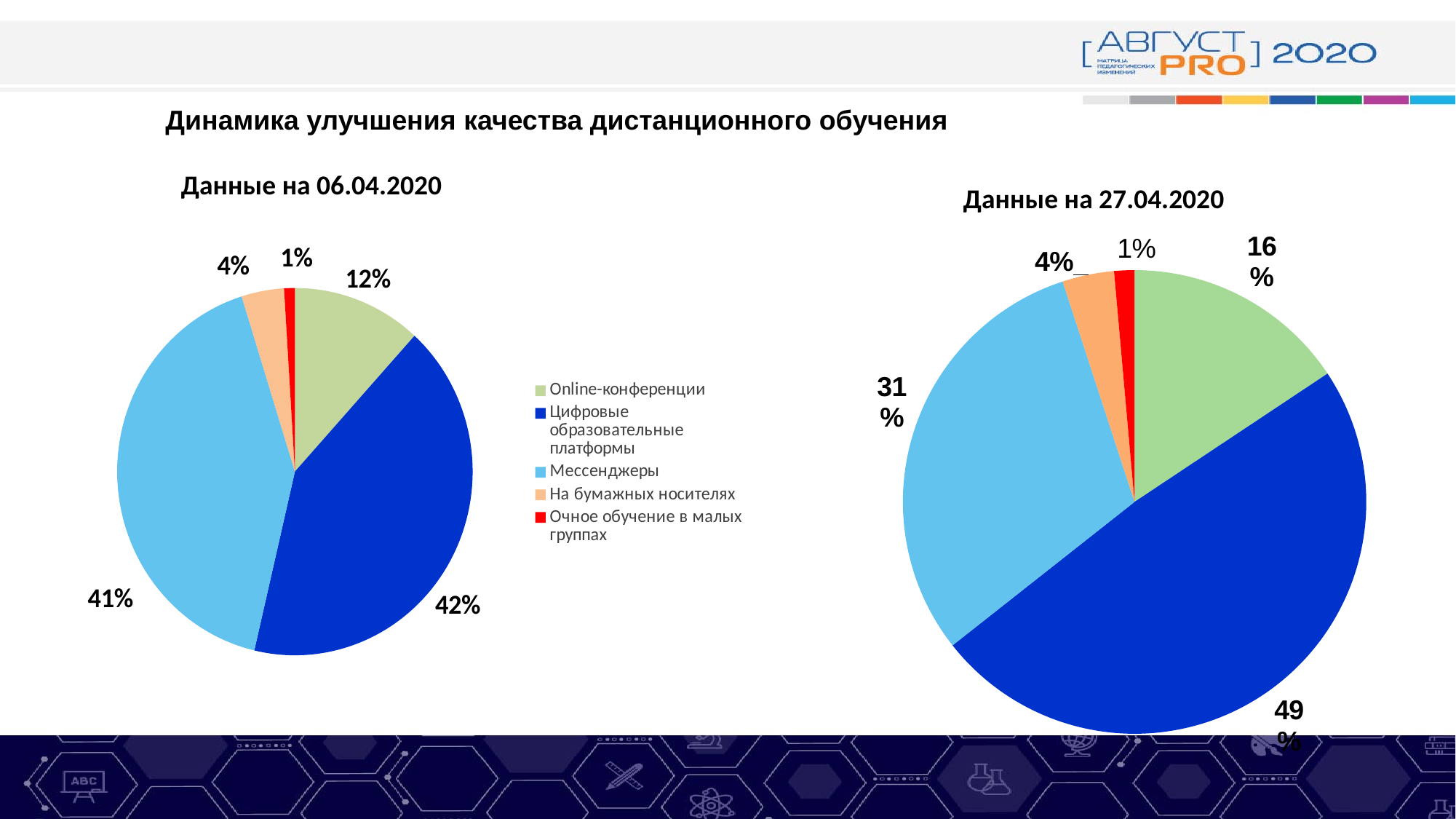
How many entries does the legend list? 5 In the chart titled "Данные на 06.04.2020", what share is shown for Мессенджеры? 41% In the chart titled "Данные на 27.04.2020", what is the difference between the shares for Цифровые образовательные платформы and Мессенджеры? 18% In the chart titled "Данные на 06.04.2020", which category has the smallest slice? Очное обучение в малых группах In the chart titled "Данные на 27.04.2020", what share is shown for Online-конференции? 16% What type of chart is "Данные на 27.04.2020"? Pie chart In the chart titled "Данные на 06.04.2020", how many slices does the pie have? 5 In the chart titled "Данные на 27.04.2020", what share is shown for Мессенджеры? 31% Which chart shows a larger share for Online-конференции, "Данные на 06.04.2020" or "Данные на 27.04.2020"? Данные на 27.04.2020 In the chart titled "Данные на 06.04.2020", what share is shown for На бумажных носителях? 4% In the chart titled "Данные на 27.04.2020", which category has the largest slice? Цифровые образовательные платформы In the chart titled "Данные на 06.04.2020", what share is shown for Цифровые образовательные платформы? 42%